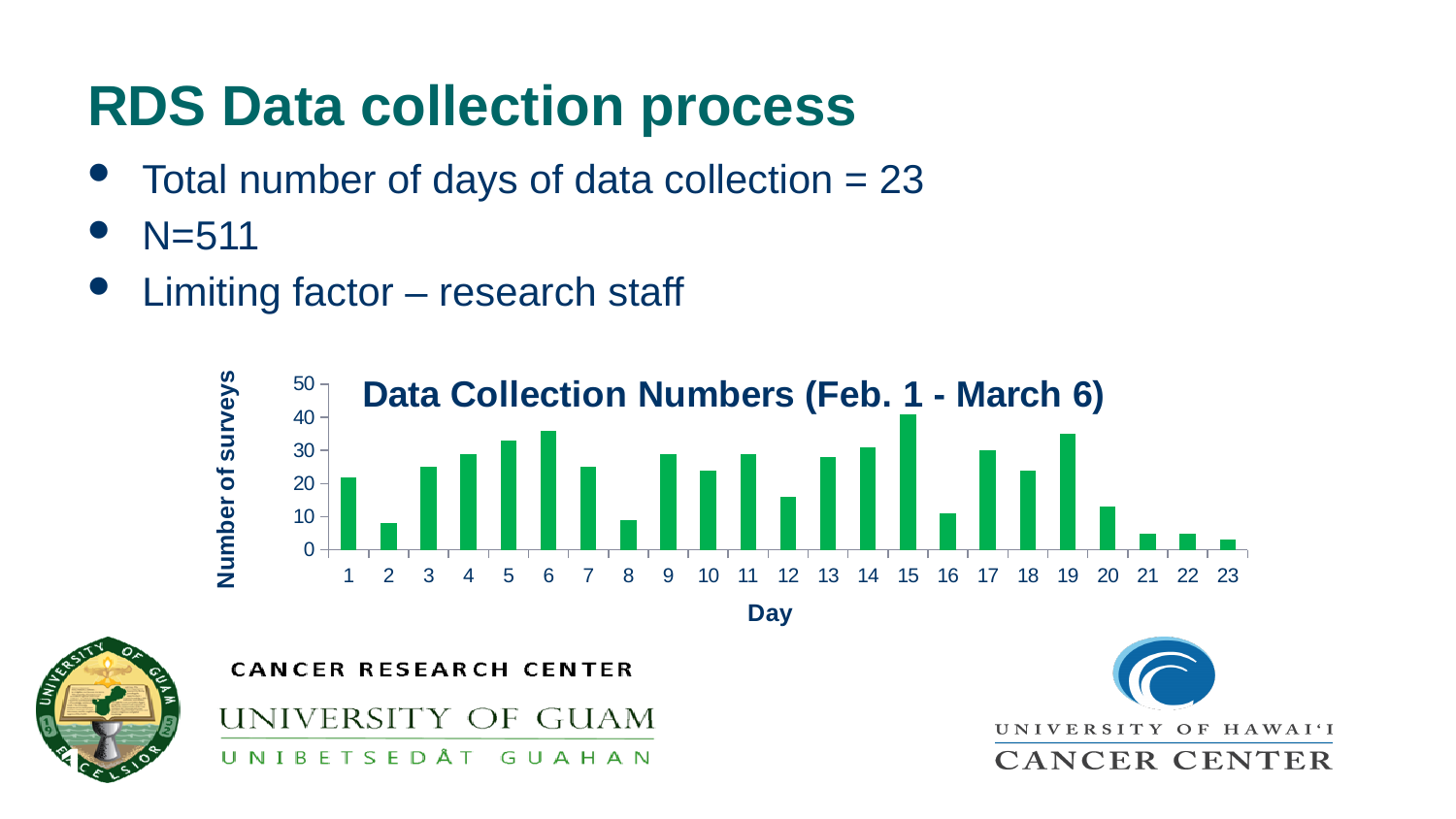
What kind of chart is shown on the slide? bar chart Which has more surveys, Day 14 or Day 16? Day 14 Is the value for Day 6 greater or less than 30? greater What is the title of the chart? Data Collection Numbers (Feb. 1 - March 6) Which has more surveys, Day 5 or Day 7? Day 5 Is the value for Day 12 greater or less than 20? less Is the value for Day 23 greater or less than 10? less Which day has the highest number of surveys? 15 What is the label on the y axis of the chart? Number of surveys How many days are plotted on the x axis of the chart? 23